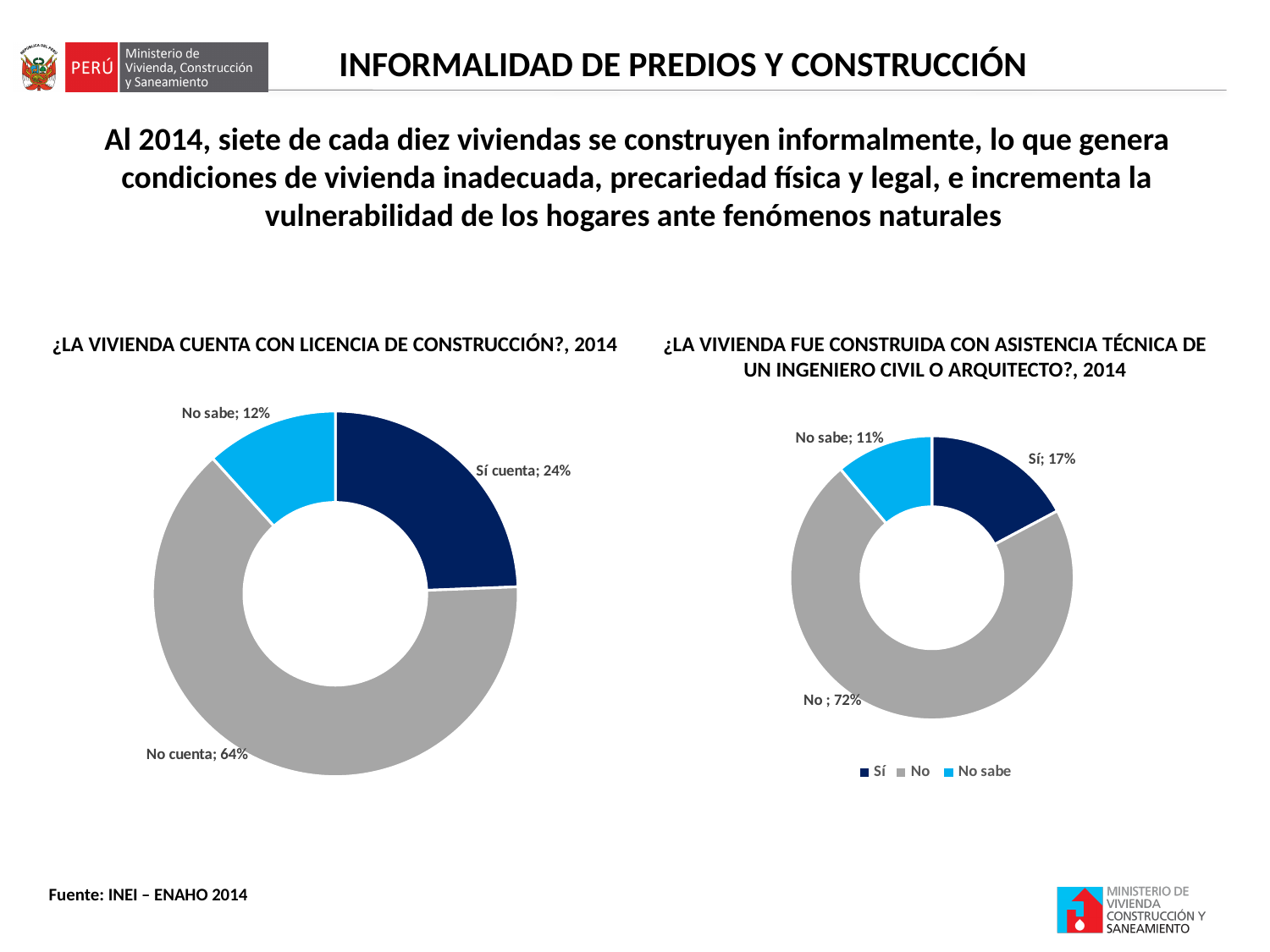
In the left chart '¿LA VIVIENDA CUENTA CON LICENCIA DE CONSTRUCCIÓN?, 2014', what is the value for 'No cuenta'? 64% In the right chart '¿LA VIVIENDA FUE CONSTRUIDA CON ASISTENCIA TÉCNICA DE UN INGENIERO CIVIL O ARQUITECTO?, 2014', what is the difference between 'No' and 'Sí'? 55% What kind of chart is the right chart '¿LA VIVIENDA FUE CONSTRUIDA CON ASISTENCIA TÉCNICA DE UN INGENIERO CIVIL O ARQUITECTO?, 2014'? Doughnut (pie) chart In the right chart '¿LA VIVIENDA FUE CONSTRUIDA CON ASISTENCIA TÉCNICA DE UN INGENIERO CIVIL O ARQUITECTO?, 2014', which category has the smallest share? No sabe In the right chart '¿LA VIVIENDA FUE CONSTRUIDA CON ASISTENCIA TÉCNICA DE UN INGENIERO CIVIL O ARQUITECTO?, 2014', what is the value for 'No'? 72% In the left chart '¿LA VIVIENDA CUENTA CON LICENCIA DE CONSTRUCCIÓN?, 2014', which category has the largest share? No cuenta In the right chart '¿LA VIVIENDA FUE CONSTRUIDA CON ASISTENCIA TÉCNICA DE UN INGENIERO CIVIL O ARQUITECTO?, 2014', what is the value for 'No sabe'? 11% In the left chart '¿LA VIVIENDA CUENTA CON LICENCIA DE CONSTRUCCIÓN?, 2014', what is the difference between 'No cuenta' and 'Sí cuenta'? 40% How many entries does the legend of the right chart list? 3 How many categories does the left chart '¿LA VIVIENDA CUENTA CON LICENCIA DE CONSTRUCCIÓN?, 2014' show? 3 Which is larger: 'Sí cuenta' in the left chart or 'Sí' in the right chart? Sí cuenta in the left chart In the left chart '¿LA VIVIENDA CUENTA CON LICENCIA DE CONSTRUCCIÓN?, 2014', what is the value for 'Sí cuenta'? 24%